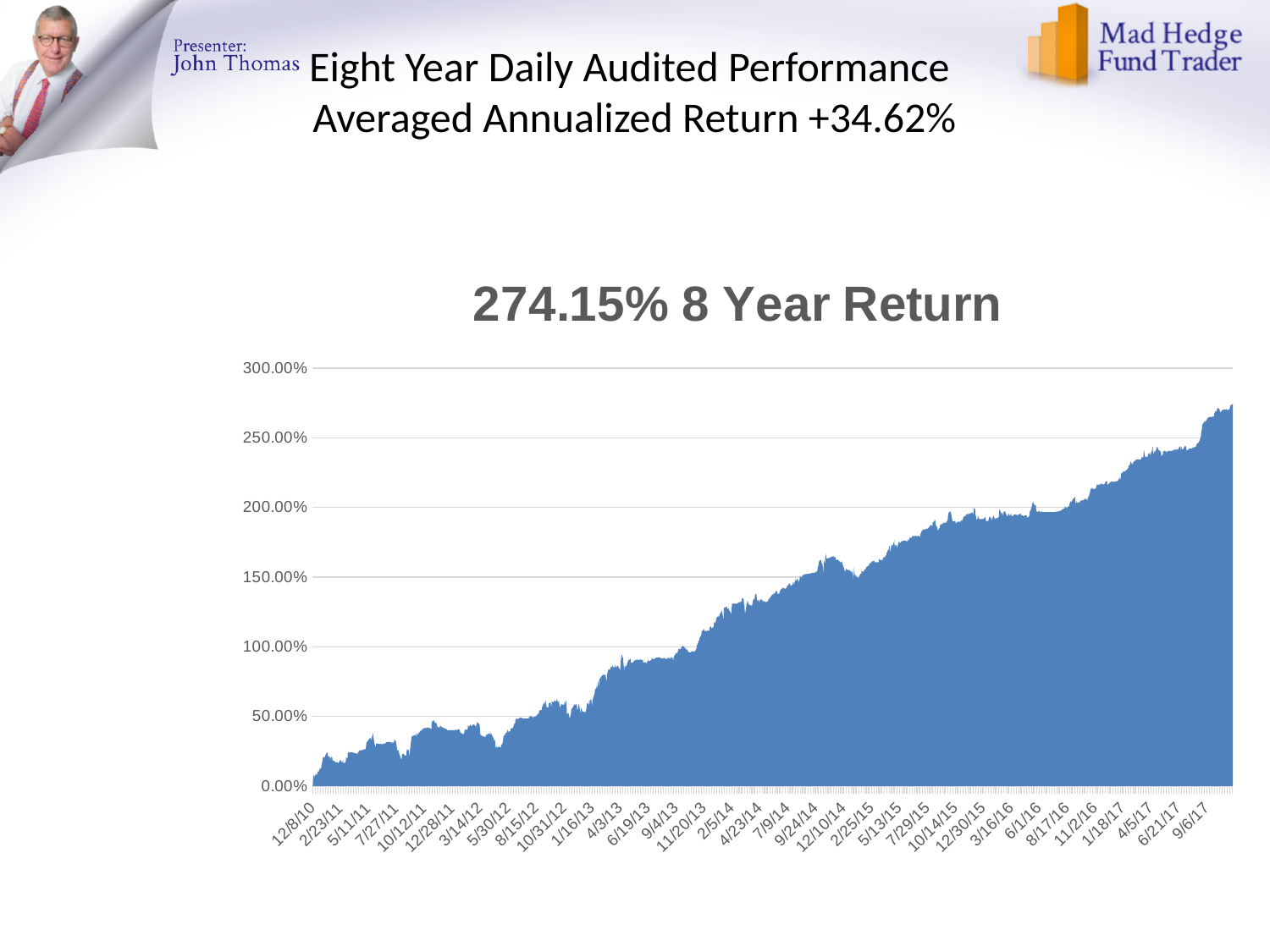
Is the value at 7/29/15 greater or less than 150.00%? greater Is the value at 4/3/13 greater or less than 100.00%? less What is the highest value shown on the y axis? 300.00% What is the title of the chart? 274.15% 8 Year Return What kind of chart is shown on the slide? area chart Is the value at 4/5/17 greater or less than 200.00%? greater Do the values generally rise or fall from left to right along the x axis? rise How many labelled tick marks are on the y axis? 7 Which is larger, the value at 12/8/10 or the value at 9/6/17? 9/6/17